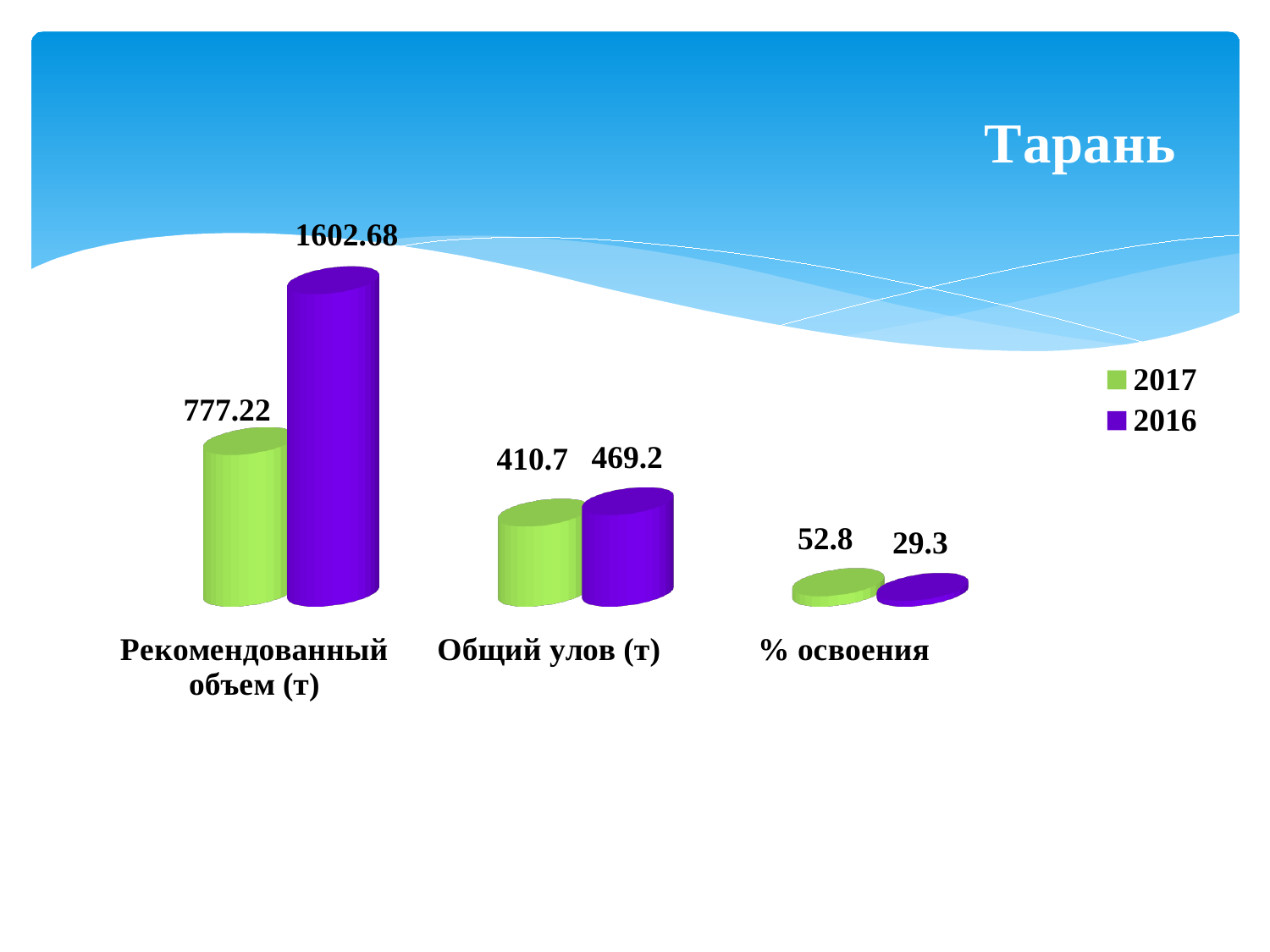
What kind of chart is shown on the slide? Bar chart What is the difference between the 2016 and 2017 values for Общий улов (т)? 58.5 How many series does the legend list? 2 How many categories are shown on the x axis? 3 For % освоения, which year has the larger value, 2017 or 2016? 2017 What is the 2017 value for Рекомендованный объем (т)? 777.22 What is the difference between the 2016 and 2017 values for Рекомендованный объем (т)? 825.46 What is the 2016 value for Рекомендованный объем (т)? 1602.68 Which category has the lowest 2017 value? % освоения Which category has the highest 2016 value? Рекомендованный объем (т) What is the 2017 value for Общий улов (т)? 410.7 What is the 2016 value for % освоения? 29.3